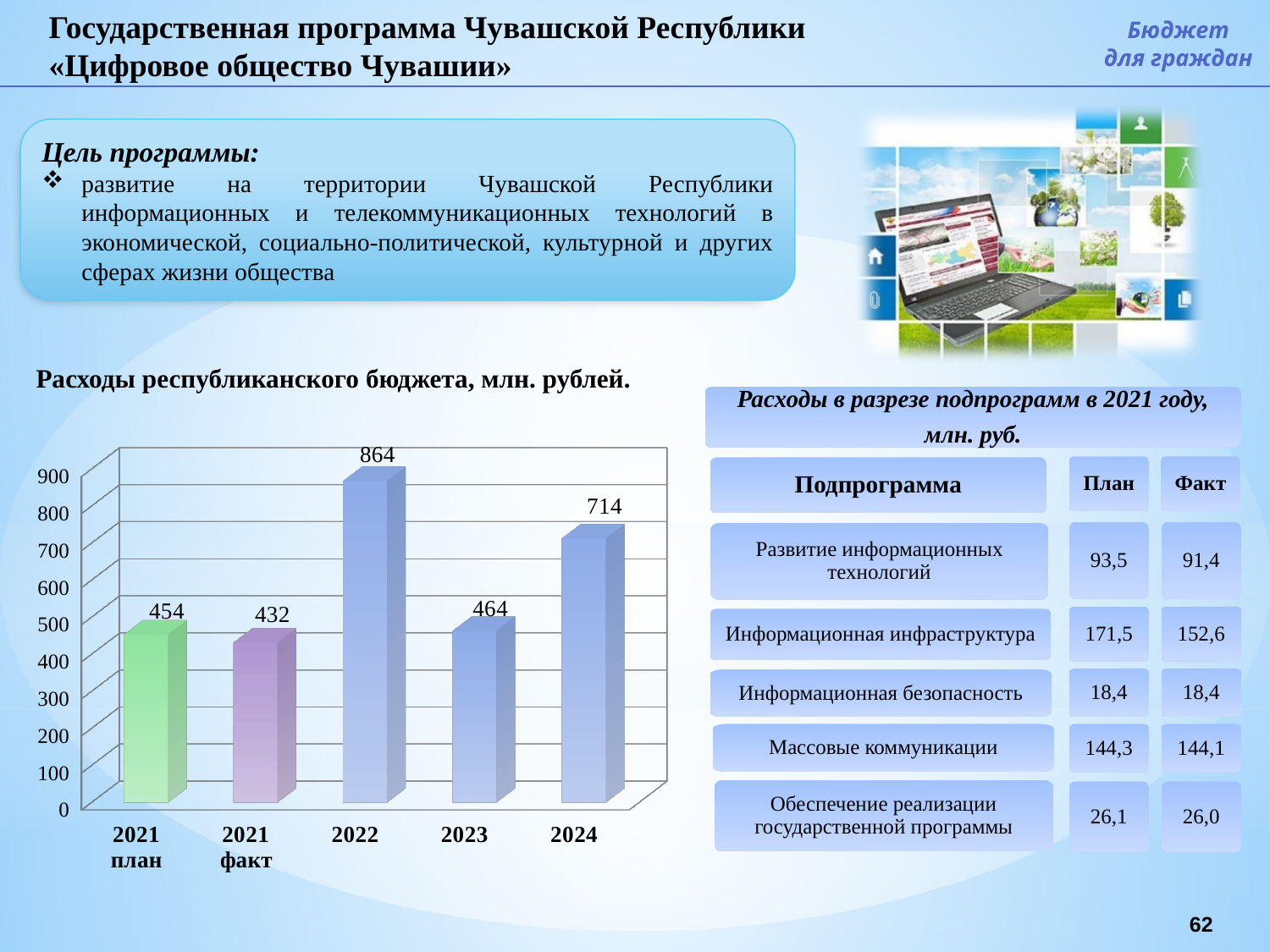
What is the difference between the values for 2021 план and 2021 факт? 22 What is the value for 2021 факт in the chart? 432 What is the value for 2024 in the chart? 714 Which category has the lowest value in the chart? 2021 факт Which is larger, the value for 2024 or the value for 2023? 2024 Which category has the highest value in the chart? 2022 What kind of chart is shown on the slide? bar chart What is the title of the chart on the slide? Расходы республиканского бюджета, млн. рублей. What is the value for 2021 план in the chart? 454 What is the difference between the values for 2022 and 2023? 400 What is the value for 2022 in the chart "Расходы республиканского бюджета, млн. рублей"? 864 How many bars are shown in the chart? 5